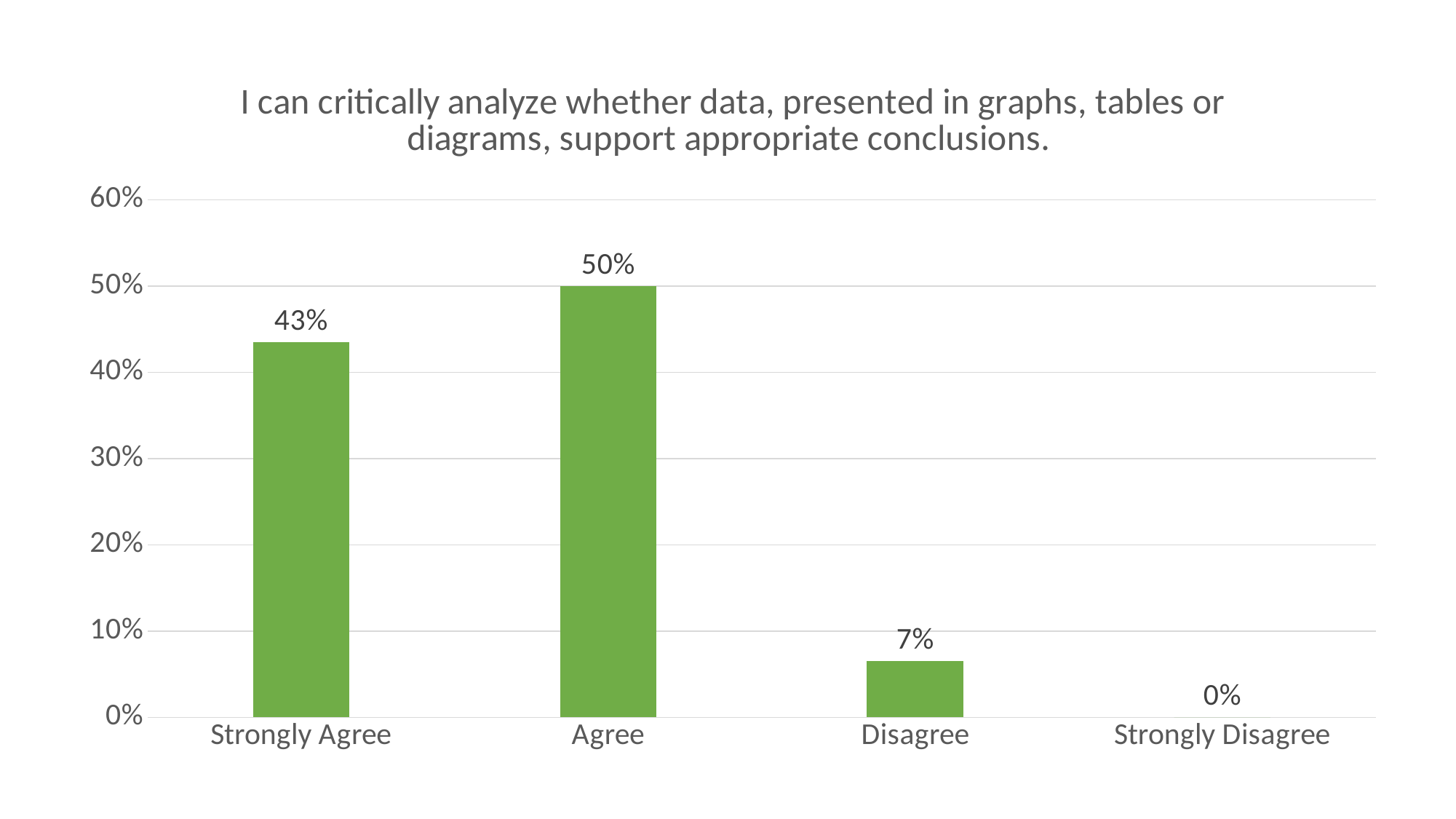
Which is larger, the value for Strongly Agree or the value for Disagree? Strongly Agree What is the value for Agree? 50% What is the value for Disagree? 7% Which category has the highest value? Agree What is the value for Strongly Disagree? 0% What is the difference between the values for Strongly Agree and Disagree? 36% What kind of chart is shown on the slide? Bar chart What is the value for Strongly Agree? 43% Which category has the lowest value? Strongly Disagree What is the title of the chart? I can critically analyze whether data, presented in graphs, tables or diagrams, support appropriate conclusions. How many categories are shown on the x axis? 4 What is the difference between the values for Agree and Strongly Agree? 7%